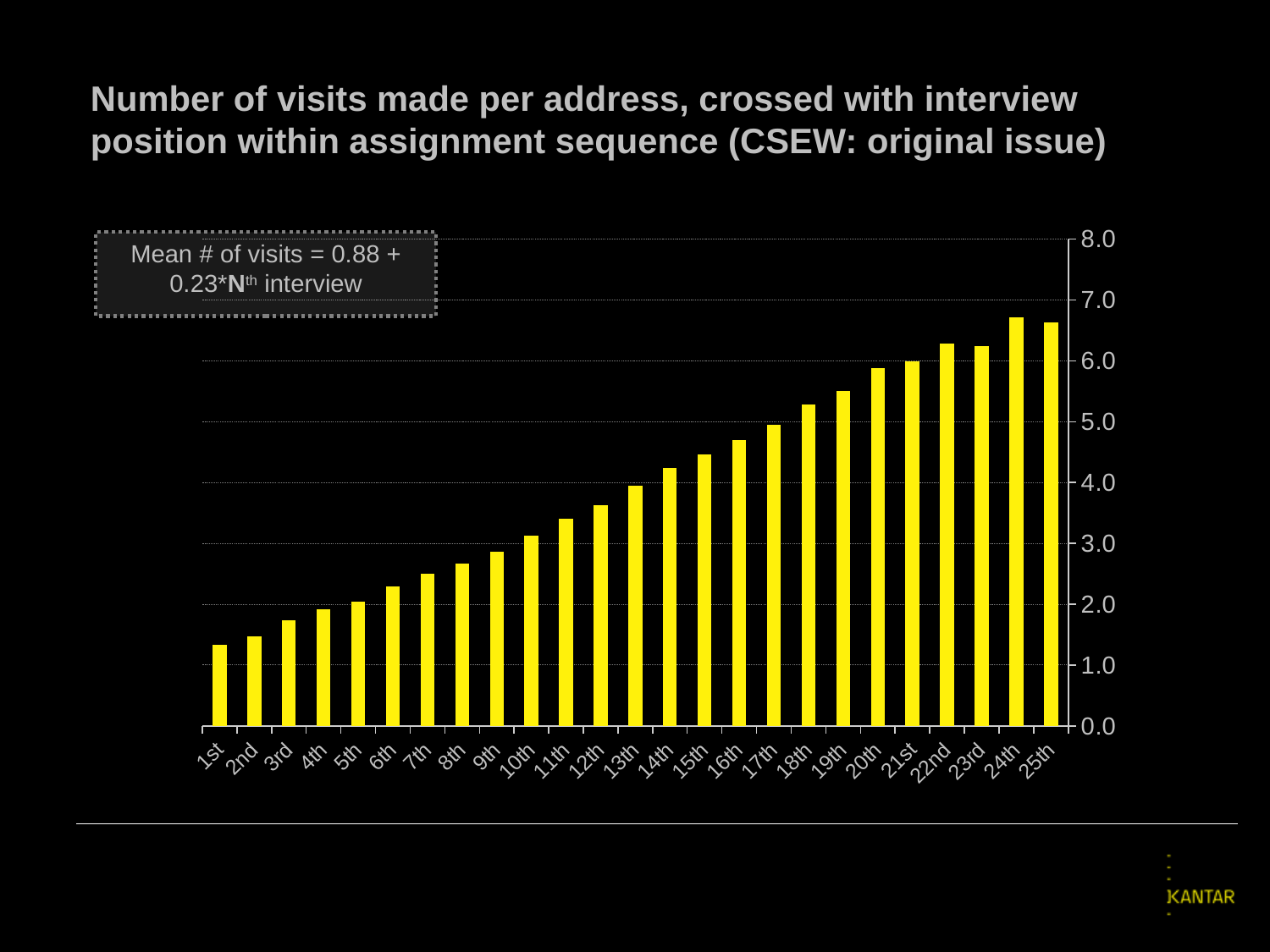
Which has a higher number of visits per address, the 10th interview or the 20th interview? 20th Is the value for the 15th interview greater or less than 4.0? greater Is the value for the 1st interview greater or less than 1.0? greater Is the value for the 3rd interview greater or less than 2.0? less What kind of chart is shown on the slide? Bar chart Do the values generally rise or fall as the interview position increases from 1st to 25th? Rise How many interview positions (categories) are plotted on the x axis? 25 Which interview position has the lowest number of visits per address? 1st According to the text box on the chart, what is the formula for the mean number of visits? 0.88 + 0.23*Nth interview